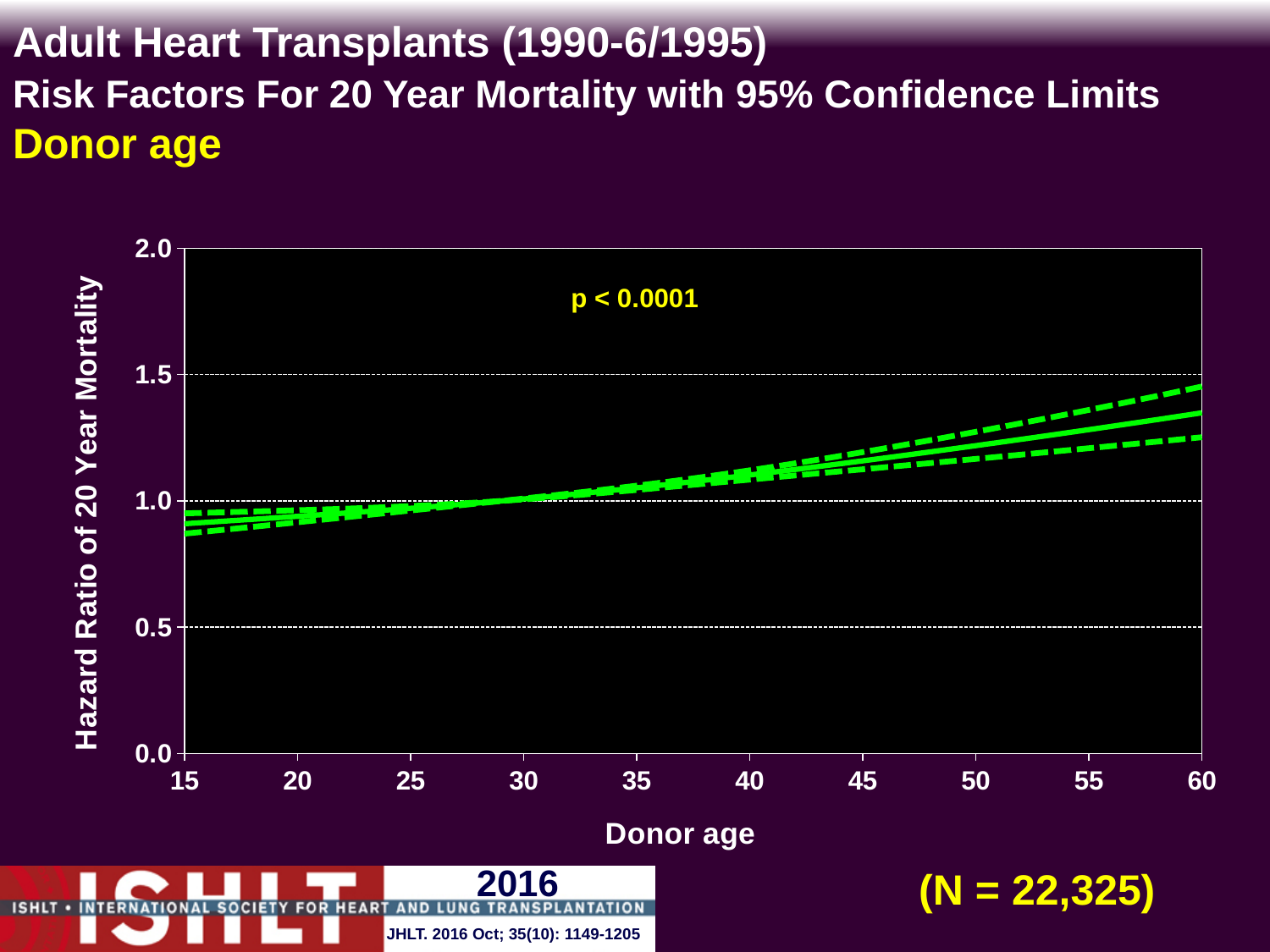
Is the hazard ratio (solid line) at donor age 60 larger or smaller than at donor age 15? larger Is the hazard ratio (solid line) at donor age 60 greater or less than 1.5? less What is the highest value shown on the y axis? 2.0 Is the lower confidence limit (lower dashed line) at donor age 60 greater or less than 1.0? greater What kind of chart is shown on the slide? line chart How many tick labels are shown on the donor age (x) axis? 10 What p-value is printed on the chart? p < 0.0001 How many lines are plotted on the chart? 3 Is the hazard ratio (solid line) at donor age 15 greater or less than 1.0? less Does the hazard ratio of 20 year mortality rise or fall as donor age increases from 15 to 60? rise